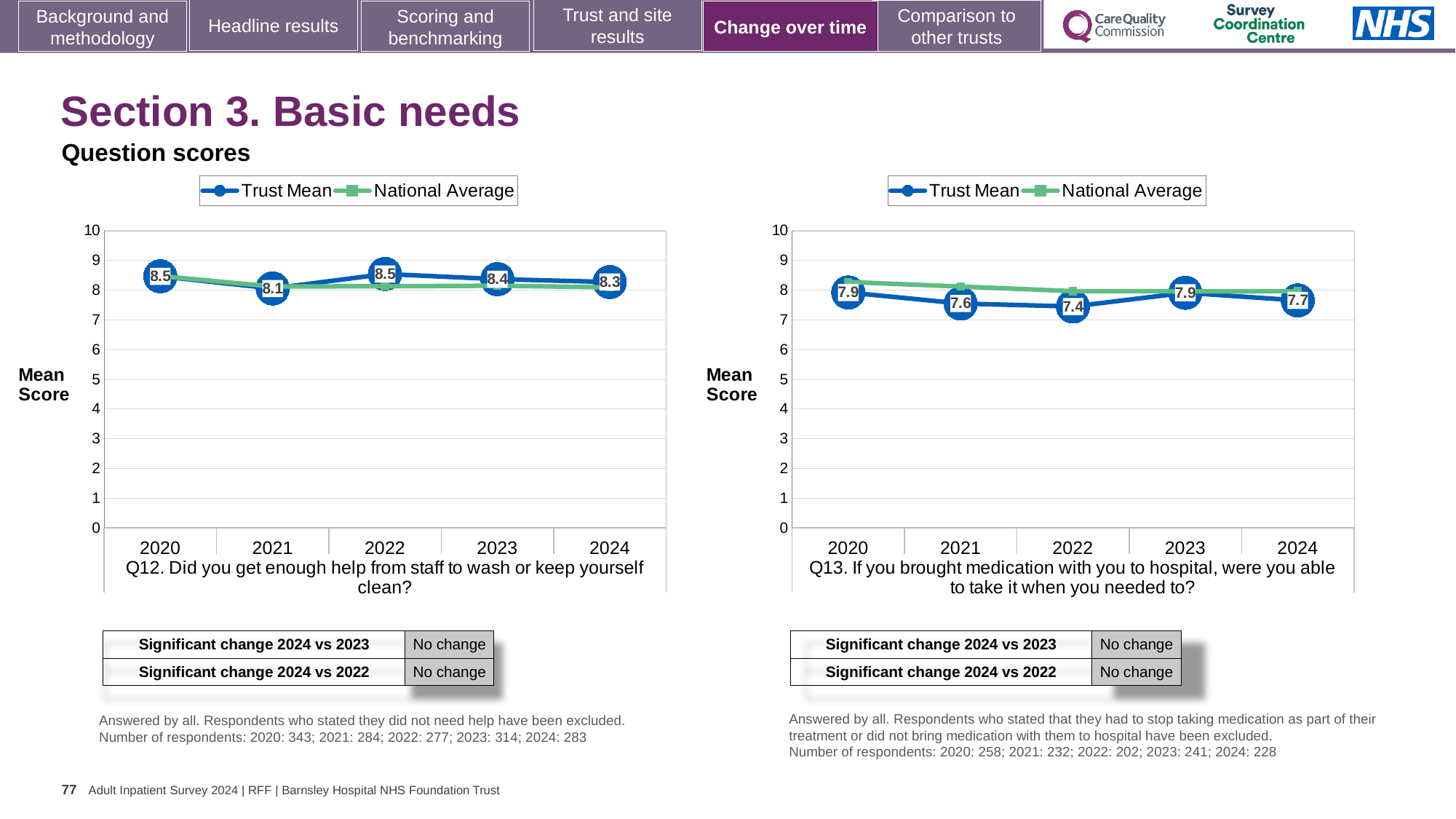
In the Q12 chart on the left, what is the difference between the Trust Mean scores for 2020 and 2021? 0.4 How many series does the legend of the Q13 chart on the right list? 2 In the Q13 chart on the right, what is the Trust Mean score for 2022? 7.4 How many years are plotted on the x axis of the Q12 chart on the left? 5 In the Q13 chart on the right, what is the difference between the Trust Mean scores for 2023 and 2022? 0.5 In the Q12 chart on the left, what is the Trust Mean score for 2021? 8.1 What type of chart is the Q12 chart on the left? Line chart In the Q13 chart on the right, is the National Average value for 2020 greater or less than 7? greater In the Q13 chart on the right, which year has the lowest Trust Mean score? 2022 In the Q12 chart on the left, what is the Trust Mean score for 2024? 8.3 In the Q12 chart on the left, which year has the lowest Trust Mean score? 2021 In the Q13 chart on the right, is the Trust Mean score higher in 2020 or in 2022? 2020